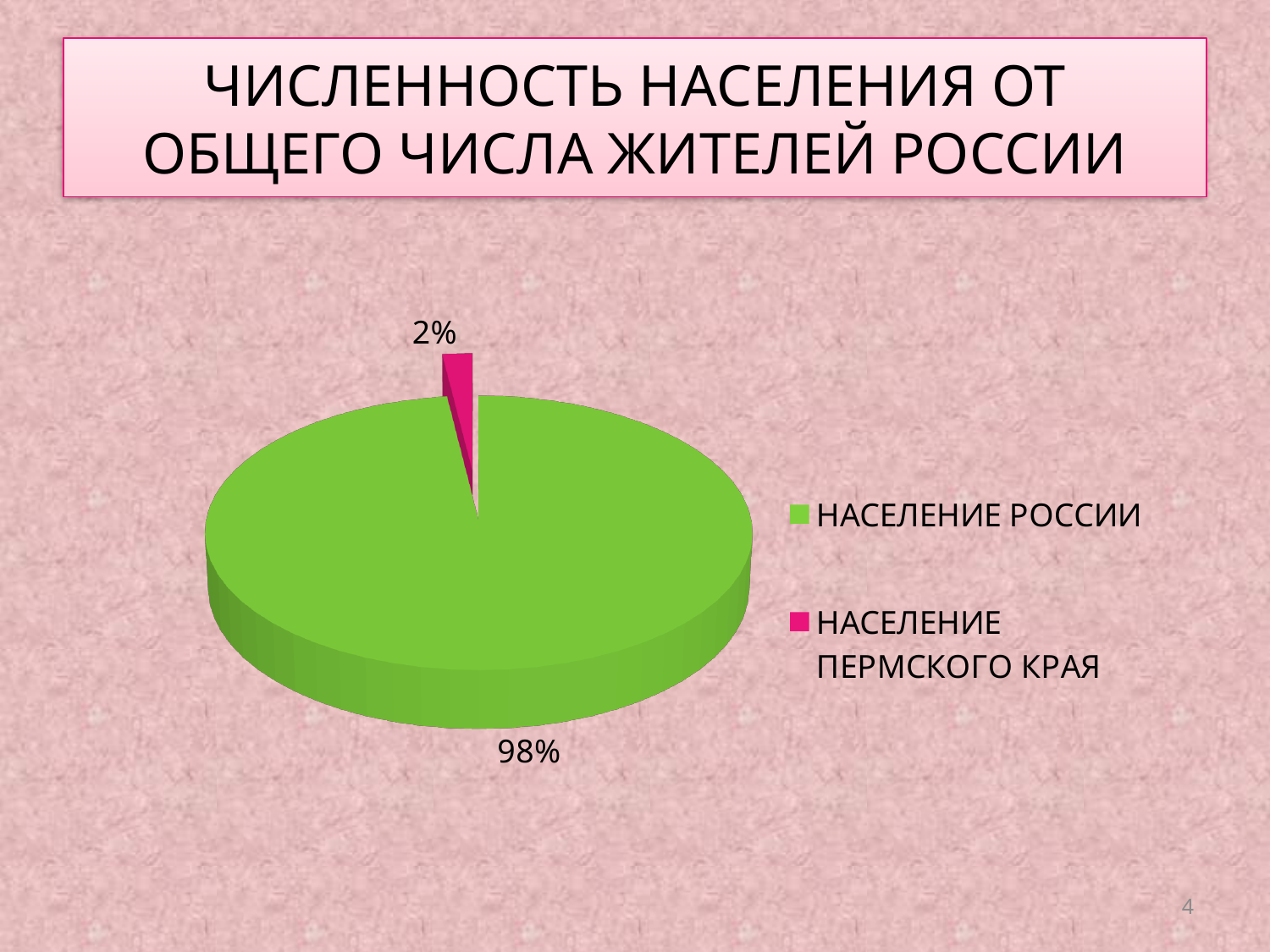
What colour is the НАСЕЛЕНИЕ ПЕРМСКОГО КРАЯ slice? pink How many slices does the pie chart have? 2 How many entries does the legend list? 2 Which slice of the pie is the largest? НАСЕЛЕНИЕ РОССИИ What share of the pie does НАСЕЛЕНИЕ РОССИИ represent? 98% What is the title of the slide containing the pie chart? ЧИСЛЕННОСТЬ НАСЕЛЕНИЯ ОТ ОБЩЕГО ЧИСЛА ЖИТЕЛЕЙ РОССИИ What kind of chart is shown on the slide? pie chart Which slice of the pie is the smallest? НАСЕЛЕНИЕ ПЕРМСКОГО КРАЯ What share of the pie does НАСЕЛЕНИЕ ПЕРМСКОГО КРАЯ represent? 2% What is the difference in percentage points between the НАСЕЛЕНИЕ РОССИИ slice and the НАСЕЛЕНИЕ ПЕРМСКОГО КРАЯ slice? 96 Which is larger, the НАСЕЛЕНИЕ РОССИИ slice or the НАСЕЛЕНИЕ ПЕРМСКОГО КРАЯ slice? НАСЕЛЕНИЕ РОССИИ